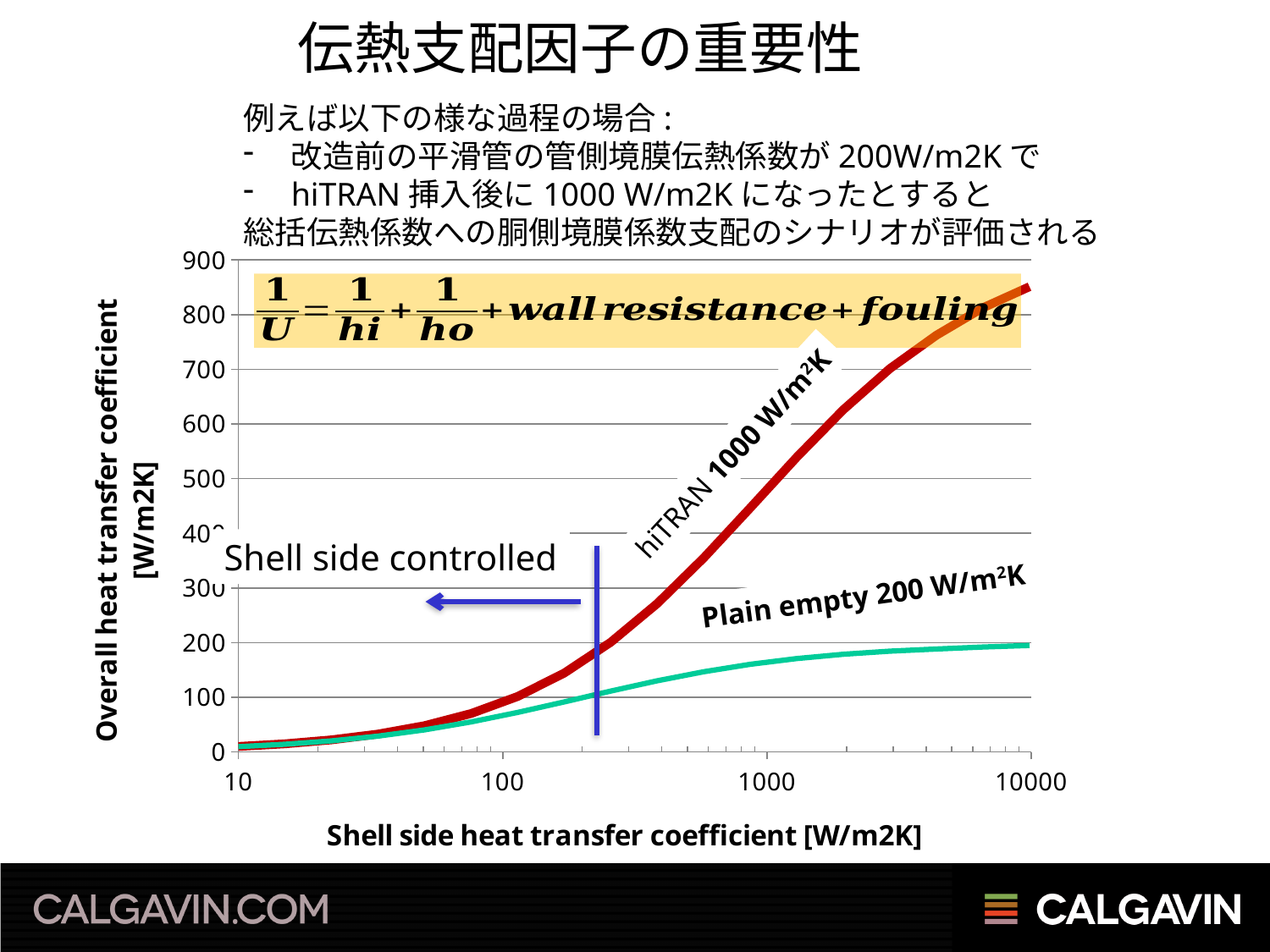
Do the curves rise or fall as the shell side heat transfer coefficient increases? rise Is the value of the Plain empty 200 W/m²K curve at a shell side coefficient of 1000 greater or less than 200? less Which curve is higher at a shell side heat transfer coefficient of 10000, hiTRAN 1000 W/m²K or Plain empty 200 W/m²K? hiTRAN 1000 W/m²K Is the value of the Plain empty 200 W/m²K curve at a shell side coefficient of 10000 greater or less than 300? less What kind of chart is shown on the slide? line chart What is the title of the x axis? Shell side heat transfer coefficient [W/m2K] What is the title of the y axis? Overall heat transfer coefficient [W/m2K] How many curves are plotted on the chart? 2 Which curve reaches the highest overall heat transfer coefficient on the chart? hiTRAN 1000 W/m²K What is the maximum value shown on the y axis? 900 Is the value of the hiTRAN 1000 W/m²K curve at a shell side coefficient of 10000 greater or less than 800? greater